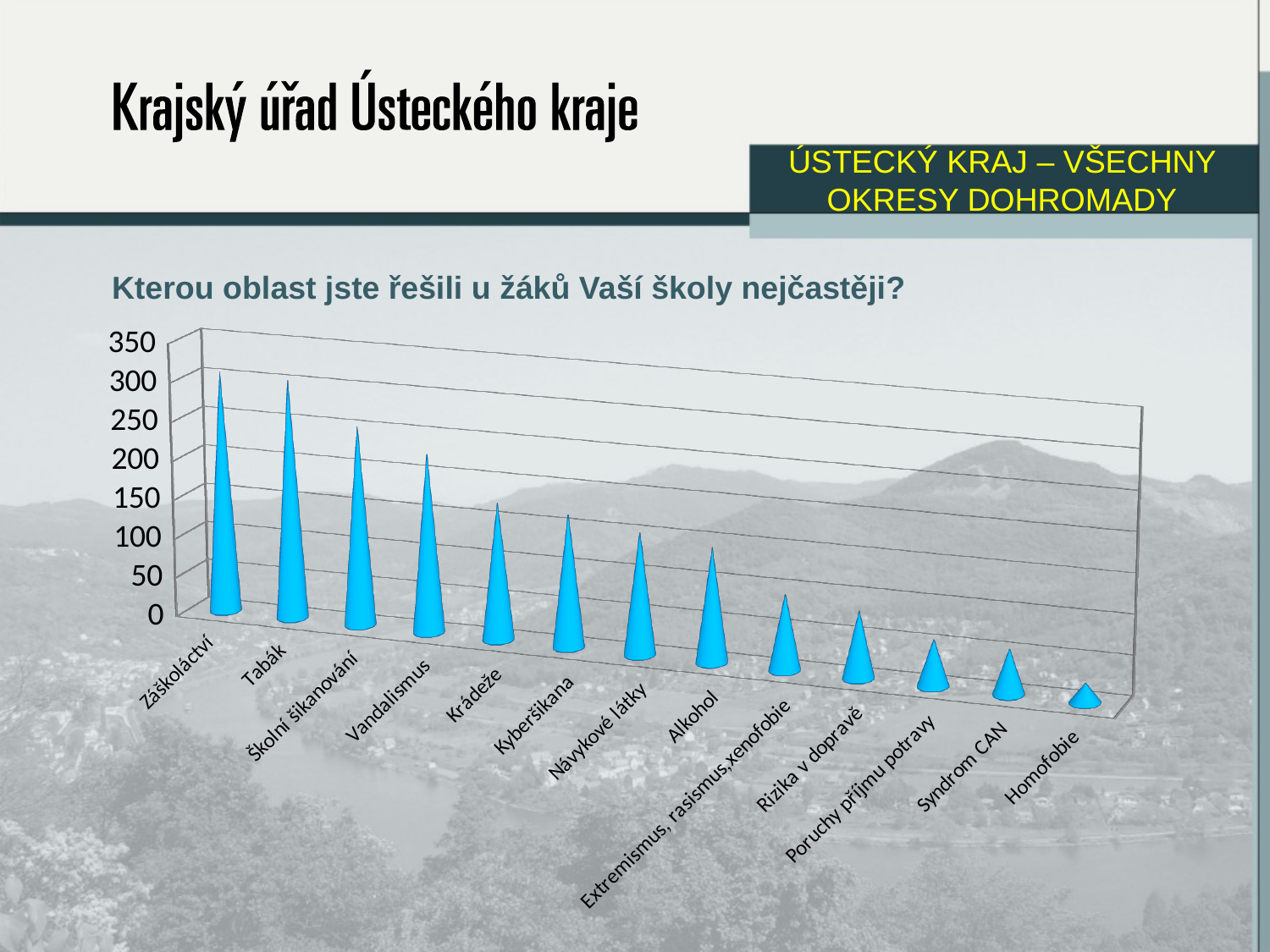
Which category has the lowest value on the chart? Homofobie Do the values rise or fall moving from left to right along the x axis? fall Which has the larger value, Vandalismus or Krádeže? Vandalismus Is the value for Homofobie greater or less than 50? less Is the value for Školní šikanování greater or less than 150? greater How many categories are plotted on the chart? 13 What kind of chart is shown on the slide? bar chart Is the value for Záškoláctví greater or less than 250? greater What question is shown as the title above the chart? Kterou oblast jste řešili u žáků Vaší školy nejčastěji? Which has the larger value, Kyberšikana or Alkohol? Kyberšikana